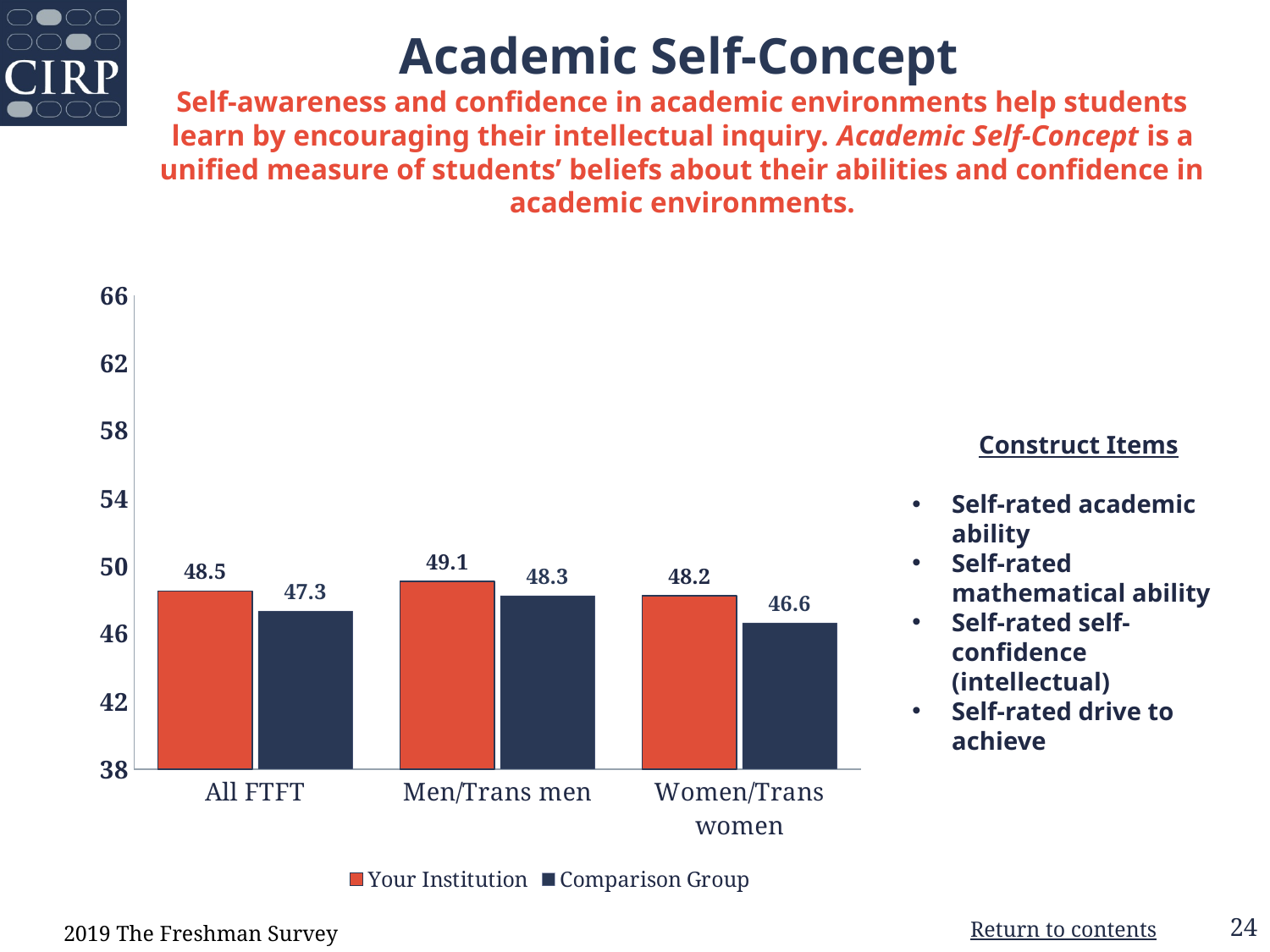
How many categories are shown on the x axis? 3 How many series does the legend list? 2 Which category has the lowest Comparison Group value? Women/Trans women What kind of chart is shown on the slide? bar chart What is the Comparison Group value for Men/Trans men? 48.3 Which category has the highest Your Institution value? Men/Trans men What is the Your Institution value for All FTFT? 48.5 Is the Comparison Group value for All FTFT greater or less than 50? less What is the difference between the Your Institution and Comparison Group values for All FTFT? 1.2 What is the Comparison Group value for Women/Trans women? 46.6 Which is larger for Men/Trans men: Your Institution or Comparison Group? Your Institution What is the difference between the Your Institution and Comparison Group values for Women/Trans women? 1.6